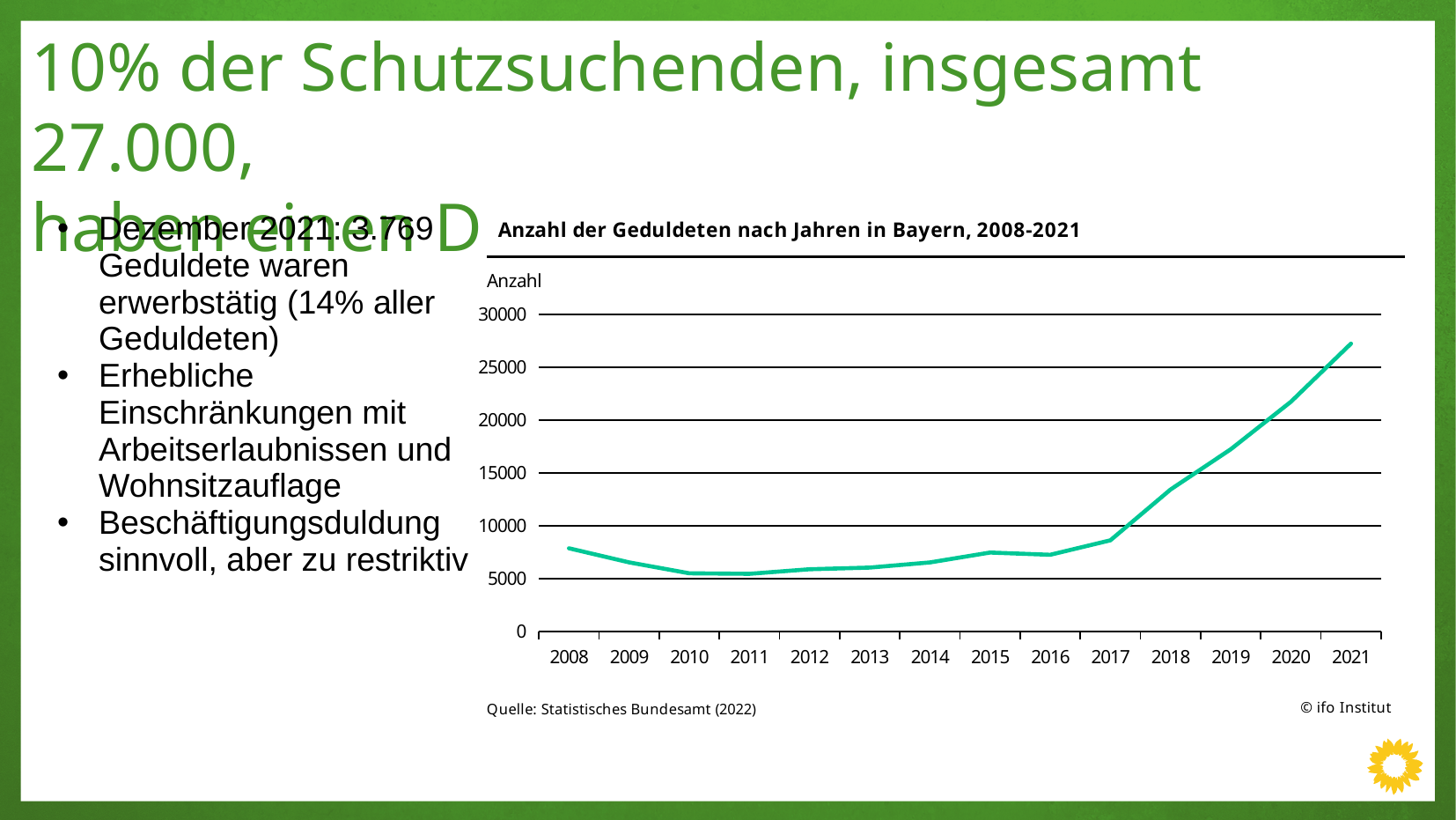
Is the value for 2021 greater or less than 25000? greater What is the title of the chart? Anzahl der Geduldeten nach Jahren in Bayern, 2008-2021 Is the value for 2008 greater or less than 10000? less How many years are plotted on the x axis of the chart? 14 Which year has the highest value in the chart? 2021 Is the value for 2018 greater or less than 10000? greater What kind of chart is shown on the slide? line chart Do the values rise or fall between 2017 and 2021? rise What source is cited below the chart? Statistisches Bundesamt (2022) Which year has the larger value, 2021 or 2008? 2021